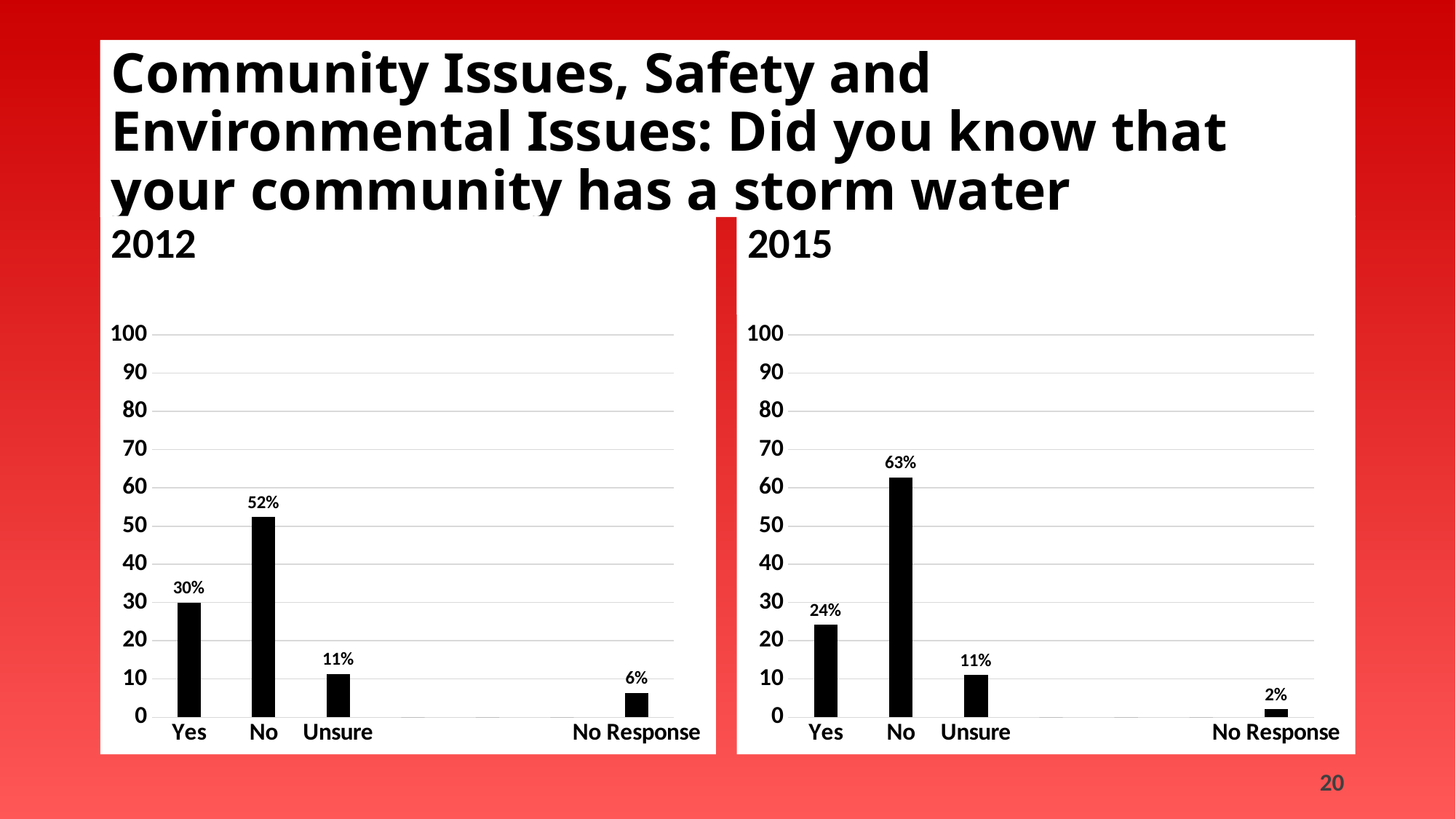
In the 2012 chart, what is the value for No Response? 6% In the 2015 chart, what is the value for No Response? 2% In the 2015 chart, which category has the highest value? No What kind of chart is the 2015 chart? bar chart In the 2012 chart, what is the value for No? 52% In the 2012 chart, what is the difference between the values for Yes and Unsure? 19% In the 2012 chart, which category has the lowest value? No Response How many labelled categories does the 2012 chart show? 4 In the 2015 chart, what is the difference between the values for No and Yes? 39% In the 2015 chart, is the value for No greater or less than 60? greater In the 2015 chart, what is the value for Yes? 24% Which is larger: the value for No in the 2012 chart or the value for No in the 2015 chart? 2015